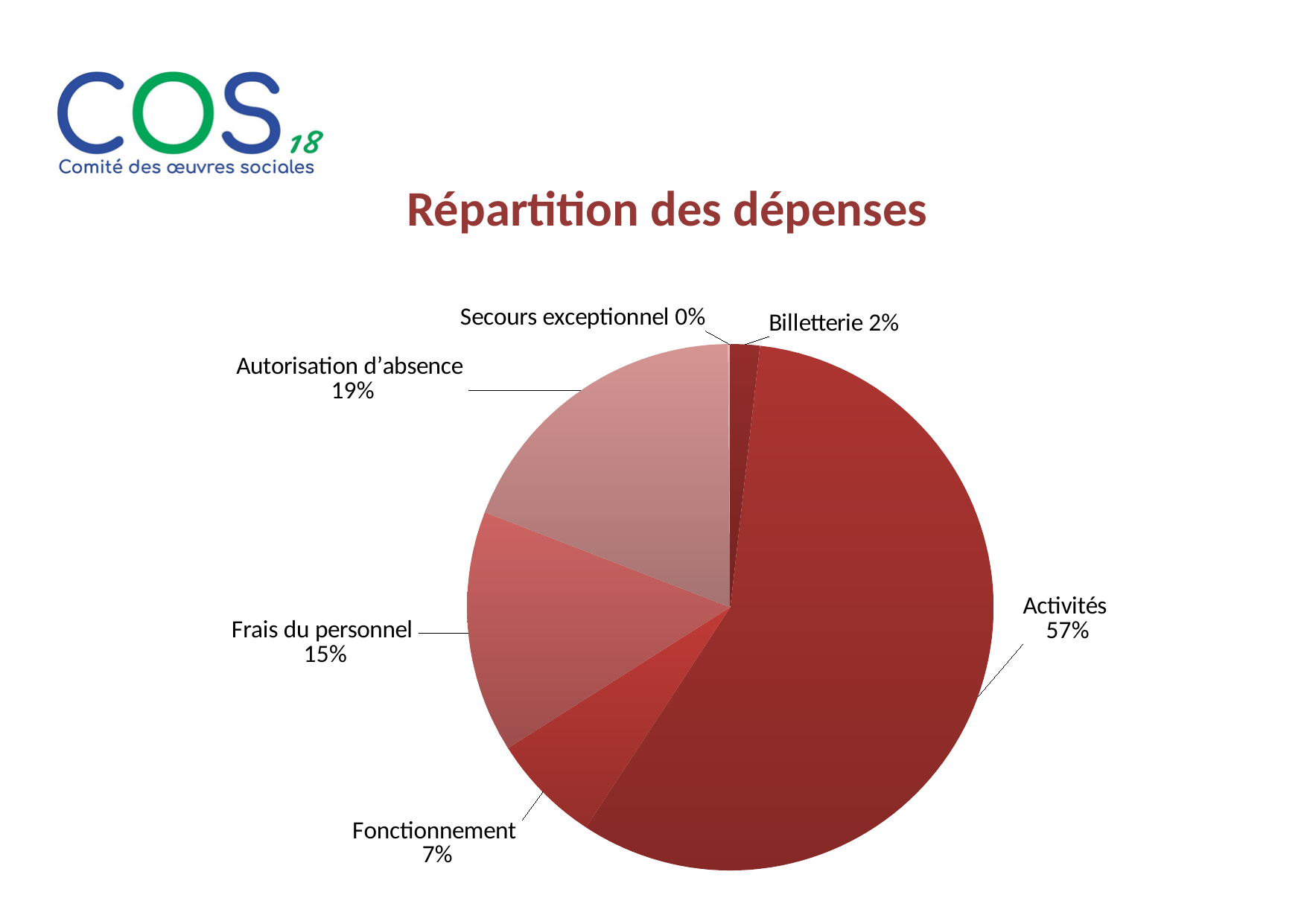
What percentage is shown for Autorisation d'absence? 19% Which category has the largest share of expenses? Activités What type of chart is shown on the slide? Pie chart What percentage is shown for Fonctionnement? 7% Which is larger, the share for Fonctionnement or the share for Billetterie? Fonctionnement How many categories are shown in the pie chart? 6 What percentage is shown for Secours exceptionnel? 0% What percentage is shown for Billetterie? 2% What percentage is shown for Frais du personnel? 15% What share of expenses does Activités represent in the pie chart? 57% Which category has the smallest share of expenses? Secours exceptionnel What is the difference in percentage points between Autorisation d'absence and Frais du personnel? 4